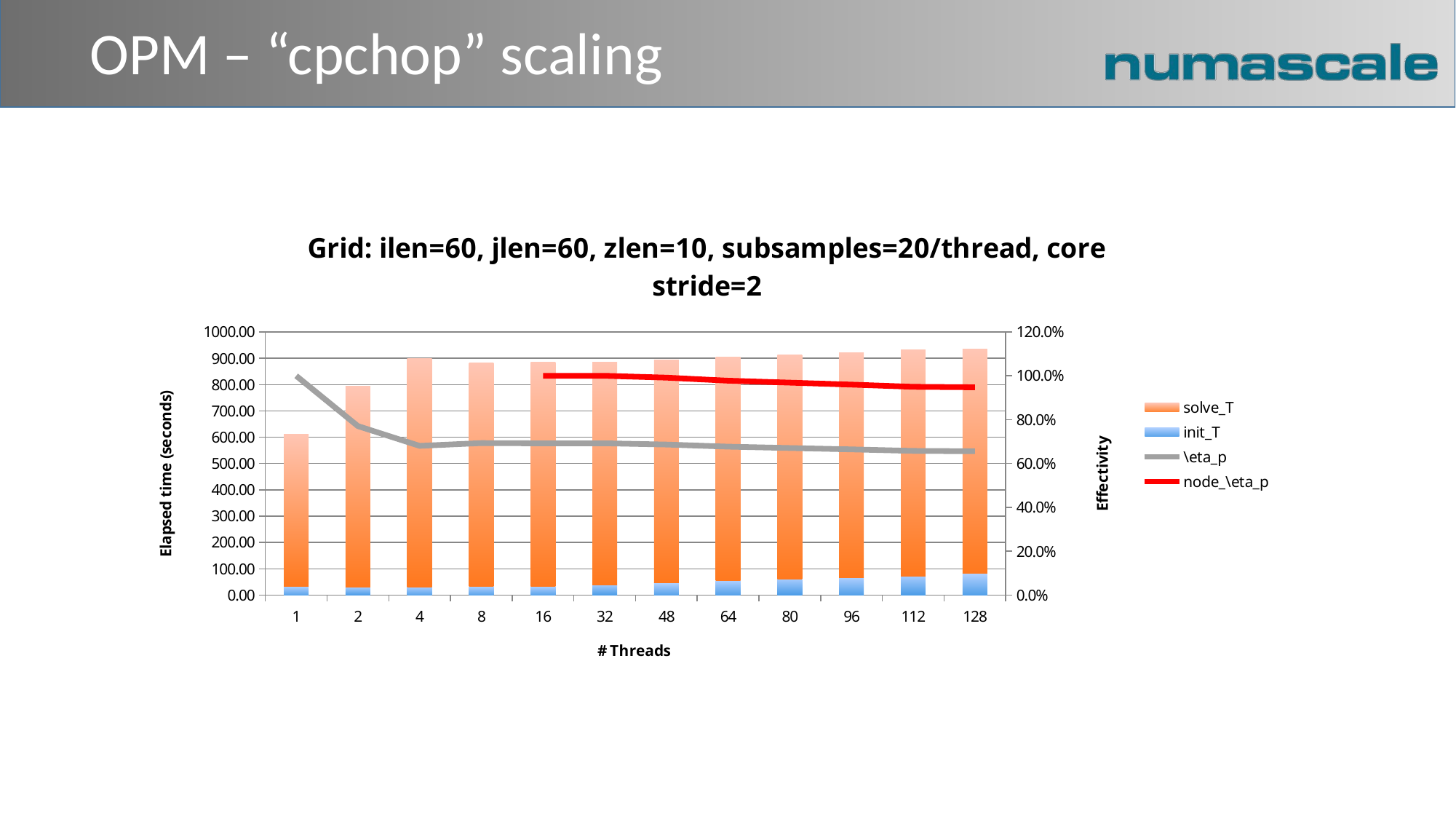
How many series does the legend list? 4 Is the total elapsed time for 128 threads greater or less than 900.00 seconds? greater Is the node_\eta_p value at 128 threads greater or less than 80.0%? greater Is the total elapsed time for 1 thread greater or less than 700.00 seconds? less Does the \eta_p line rise or fall as the number of threads increases? fall What kind of chart is this? A stacked bar chart combined with line series Which has the larger total elapsed time bar, 1 thread or 2 threads? 2 How many thread counts are shown on the x axis? 12 What is the label of the left vertical axis? Elapsed time (seconds) Which thread count has the lowest total elapsed time bar? 1 What is the title of the chart? Grid: ilen=60, jlen=60, zlen=10, subsamples=20/thread, core stride=2